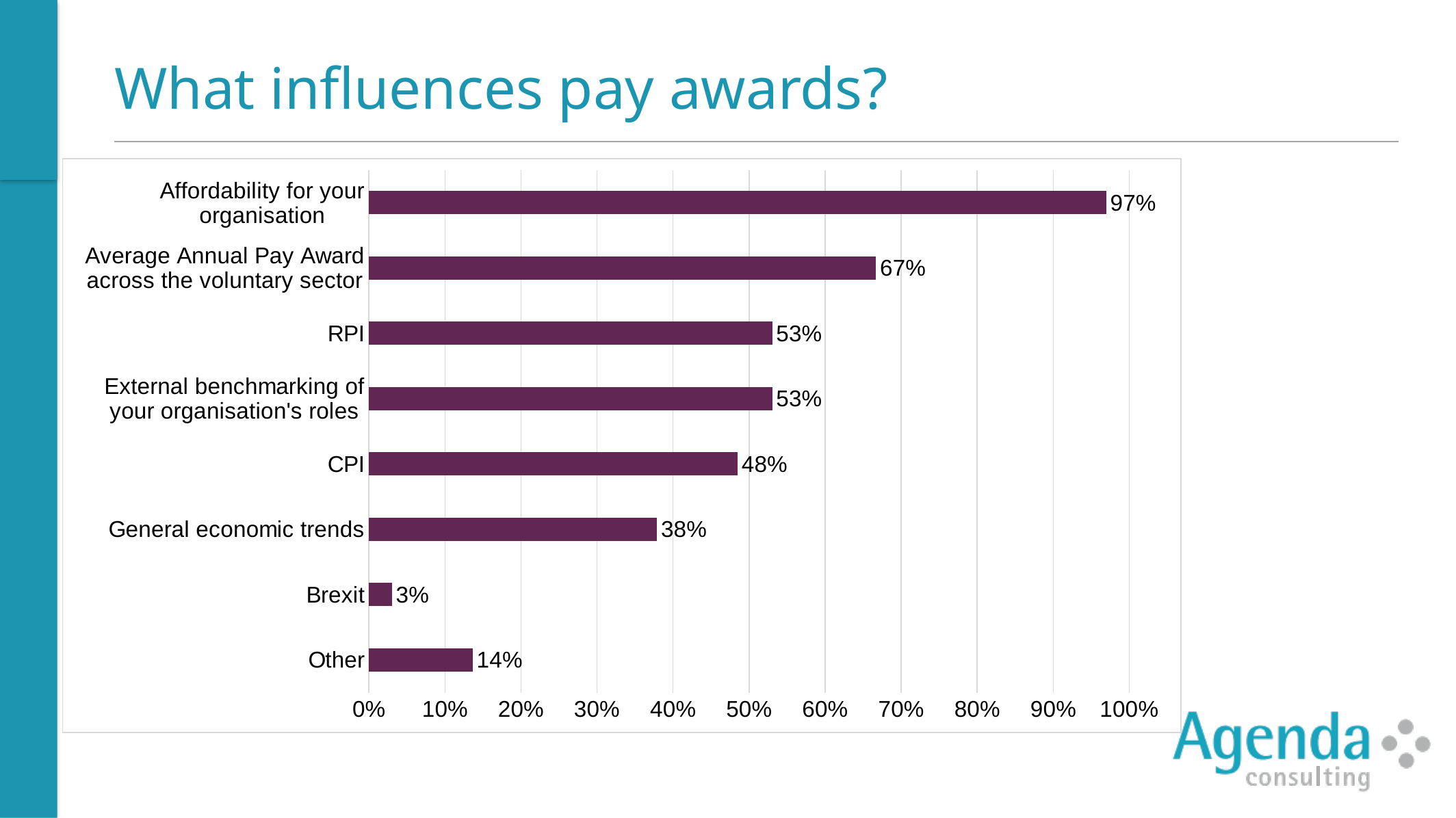
Which category has the highest value? Affordability for your organisation What is the title of the slide? What influences pay awards? What kind of chart is shown on the slide? Bar chart What is the value for Brexit? 3% What is the difference between the values for Affordability for your organisation and Average Annual Pay Award across the voluntary sector? 30% How many categories are shown in the chart? 8 Which is larger, the value for CPI or the value for General economic trends? CPI What is the value for Average Annual Pay Award across the voluntary sector? 67% What is the difference between the values for Other and Brexit? 11% What is the value for Affordability for your organisation? 97% Which category has the lowest value? Brexit What is the value for CPI? 48%